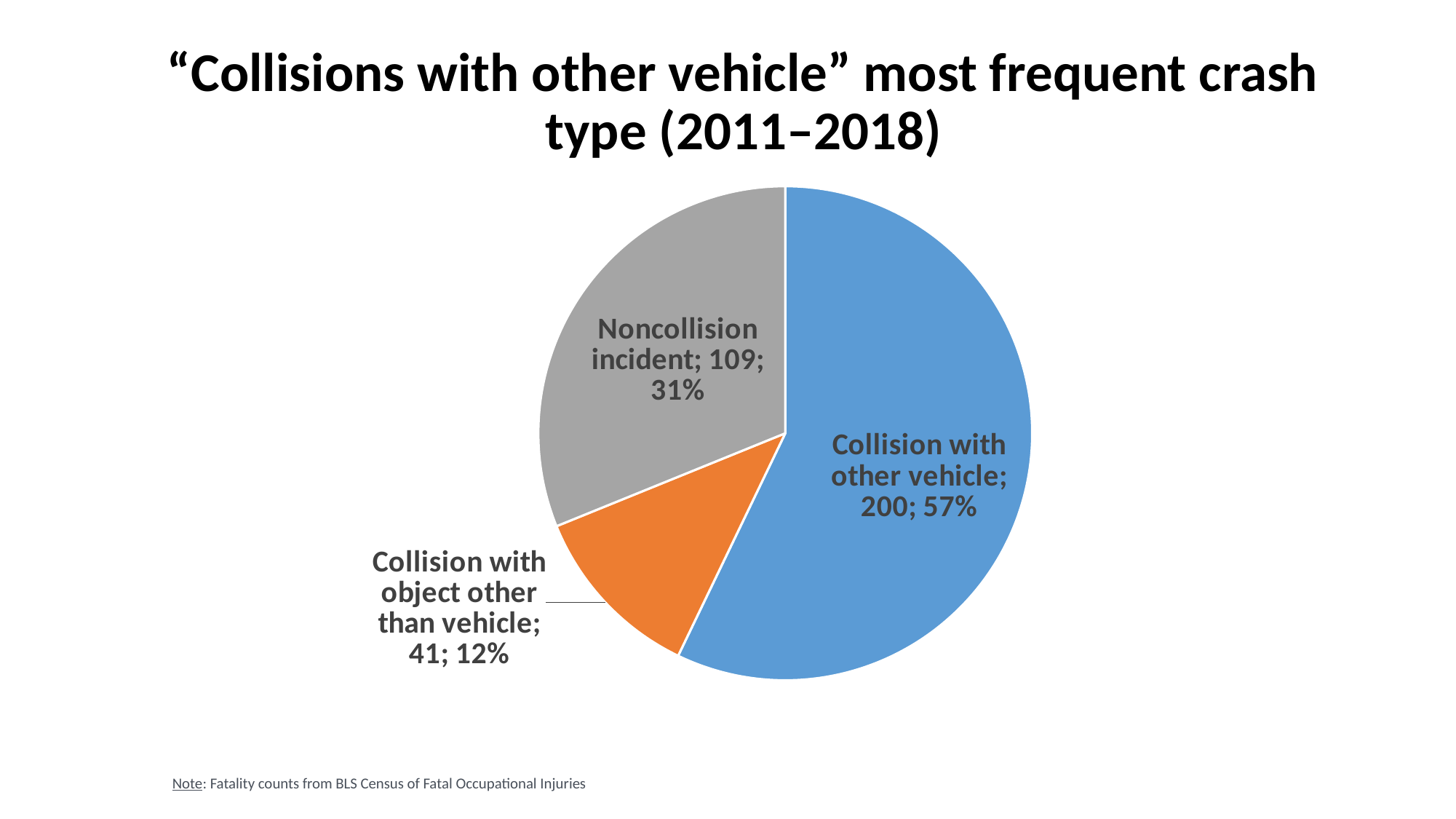
What is the difference in fatality counts between "Collision with other vehicle" and "Noncollision incident"? 91 Which crash type has the smallest slice? Collision with object other than vehicle How many slices does the pie chart have? 3 What share of the pie does "Collision with object other than vehicle" represent? 12% What share of the pie does "Noncollision incident" represent? 31% What is the fatality count for "Collision with other vehicle"? 200 What is the fatality count for "Noncollision incident"? 109 What colour is the "Collision with other vehicle" slice? blue Which has a higher fatality count, "Noncollision incident" or "Collision with object other than vehicle"? Noncollision incident What is the fatality count for "Collision with object other than vehicle"? 41 What kind of chart is shown on the slide? pie chart Which crash type has the largest slice? Collision with other vehicle